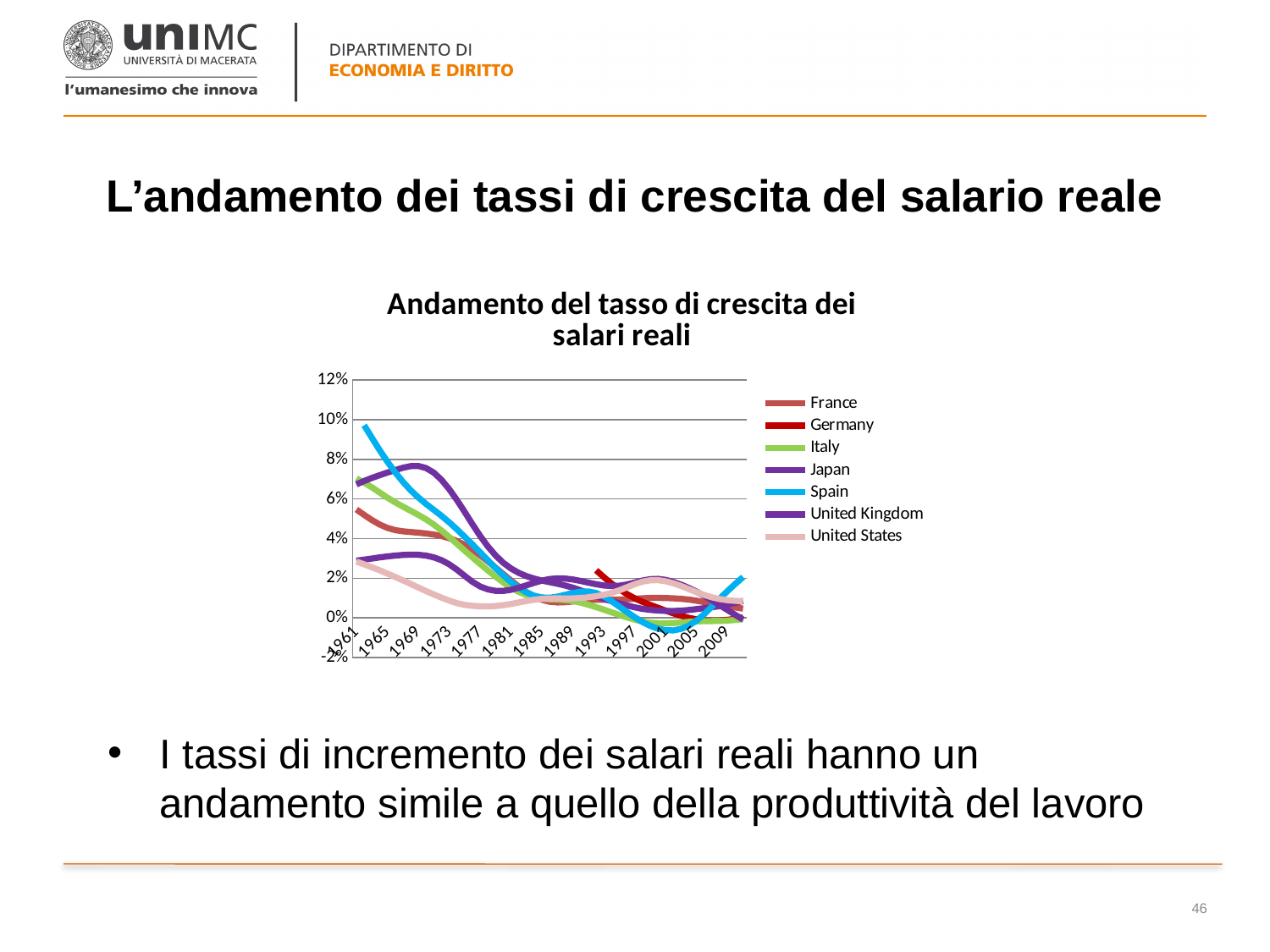
What kind of chart is shown on the slide? Line chart How many year labels are shown on the x axis? 13 What is the highest value shown on the y axis? 12% Is the value for France in 1961 greater or less than 4%? greater How many series does the chart legend list? 7 Is the value for Italy in 1961 greater or less than 4%? greater Is the value for Japan in 1961 greater or less than 6%? greater What is the title of the chart? Andamento del tasso di crescita dei salari reali Does the Spain series rise or fall between 1961 and 2001? Fall